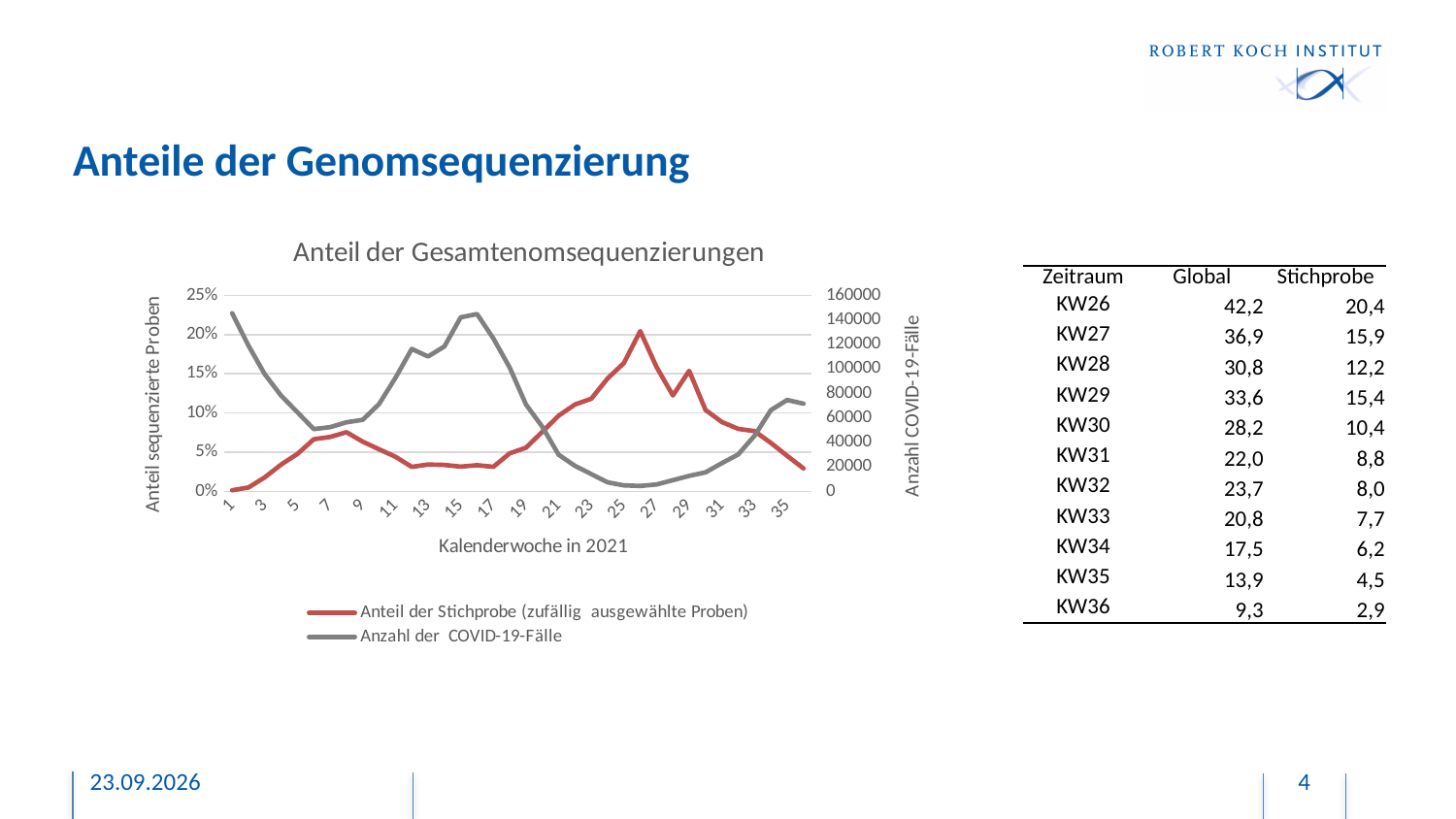
At which Kalenderwoche does the 'Anteil der Stichprobe' series reach its highest value? 26 Does the 'Anteil der Stichprobe' series rise or fall between Kalenderwoche 19 and Kalenderwoche 27? rise Is the 'Anteil der Stichprobe' value larger at Kalenderwoche 27 or at Kalenderwoche 13? Kalenderwoche 27 What is the x-axis title of the chart? Kalenderwoche in 2021 How many series does the chart legend list? 2 What kind of chart is shown on the slide? line chart Is the value of 'Anteil der Stichprobe' at Kalenderwoche 13 greater or less than 5%? less Is the value of 'Anzahl der COVID-19-Fälle' at Kalenderwoche 25 greater or less than 20000? less What is the title of the chart? Anteil der Gesamtenomsequenzierungen Does the 'Anzahl der COVID-19-Fälle' series rise or fall between Kalenderwoche 1 and Kalenderwoche 7? fall Is the value of 'Anzahl der COVID-19-Fälle' at Kalenderwoche 15 greater or less than 120000? greater